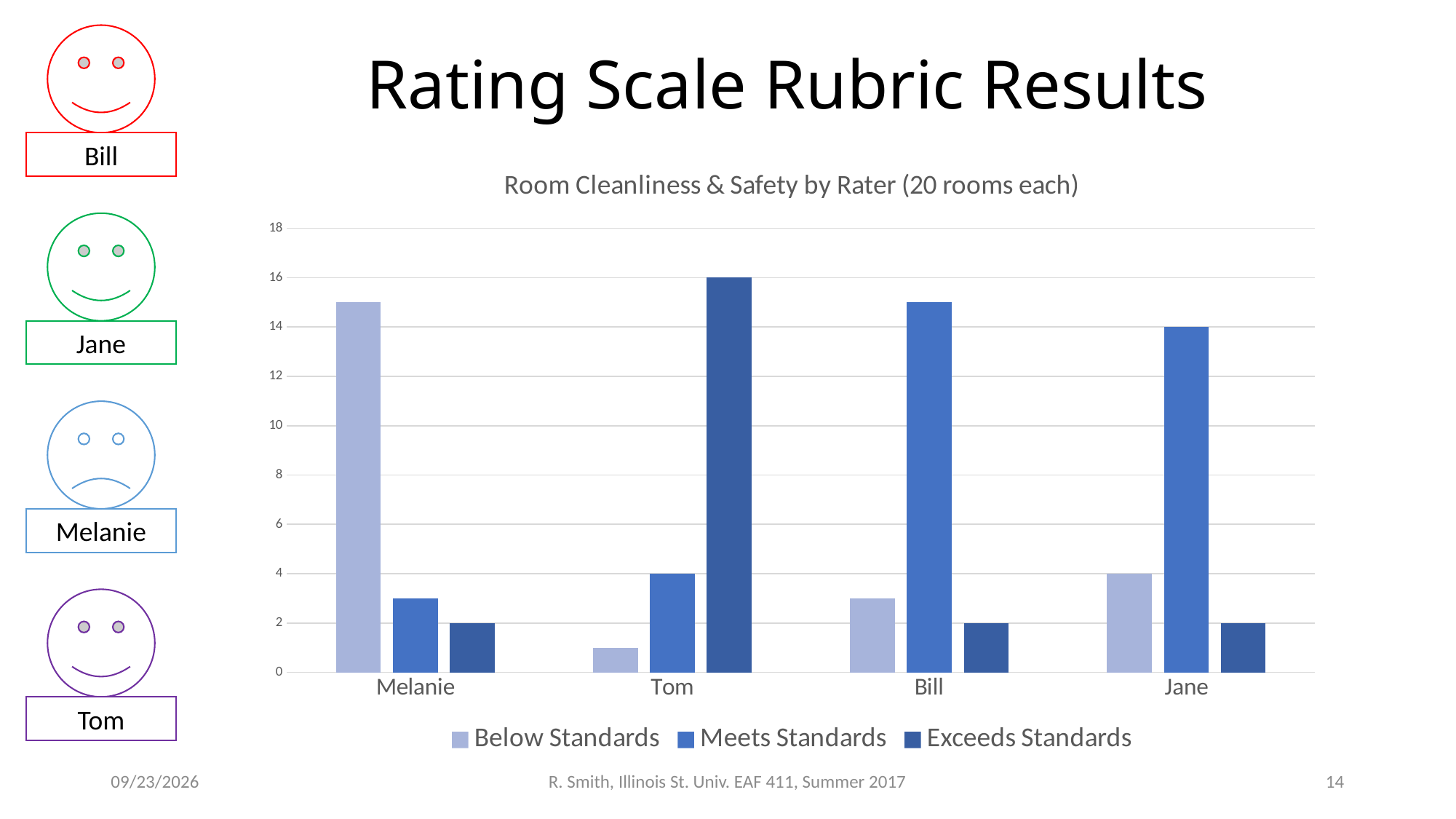
How many series does the legend list? 3 What type of chart is shown on the slide? bar chart Is the Below Standards value for Melanie greater or less than 10? greater What is the difference between Tom's Exceeds Standards value and Tom's Meets Standards value? 12 What is the Exceeds Standards value for Tom? 16 Which rater has the highest Exceeds Standards value? Tom Which rater has the highest Below Standards value? Melanie What is the Meets Standards value for Tom? 4 What is the Meets Standards value for Jane? 14 What is the Below Standards value for Jane? 4 How many raters are shown on the x axis? 4 What is the title of the chart? Room Cleanliness & Safety by Rater (20 rooms each)